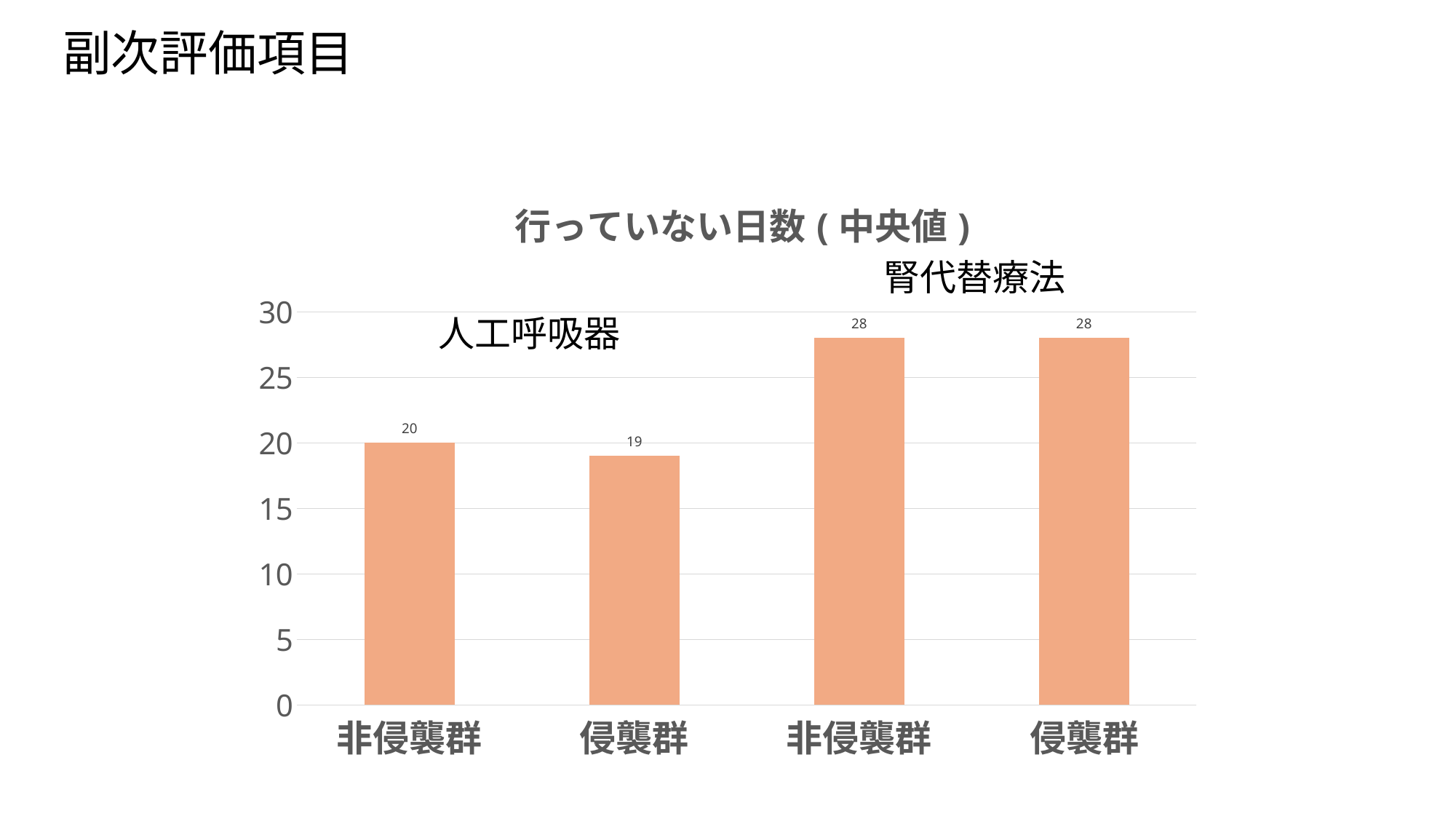
What is the value for 侵襲群 under 人工呼吸器? 19 What is the title of the chart? 行っていない日数 ( 中央値 ) What is the value for 侵襲群 under 腎代替療法? 28 How many bars are plotted in the chart? 4 What is the difference between the 非侵襲群 value under 腎代替療法 and the 非侵襲群 value under 人工呼吸器? 8 What is the value for 非侵襲群 under 人工呼吸器 in the chart 行っていない日数 ( 中央値 )? 20 Is the value for 侵襲群 under 腎代替療法 greater or less than 25? greater Which bar has the lowest value in the chart? 侵襲群 (人工呼吸器) What is the difference between the 非侵襲群 and 侵襲群 values under 人工呼吸器? 1 What kind of chart is shown on the slide? bar chart Which is larger: the 侵襲群 value under 人工呼吸器 or the 侵襲群 value under 腎代替療法? 侵襲群 under 腎代替療法 What is the value for 非侵襲群 under 腎代替療法? 28